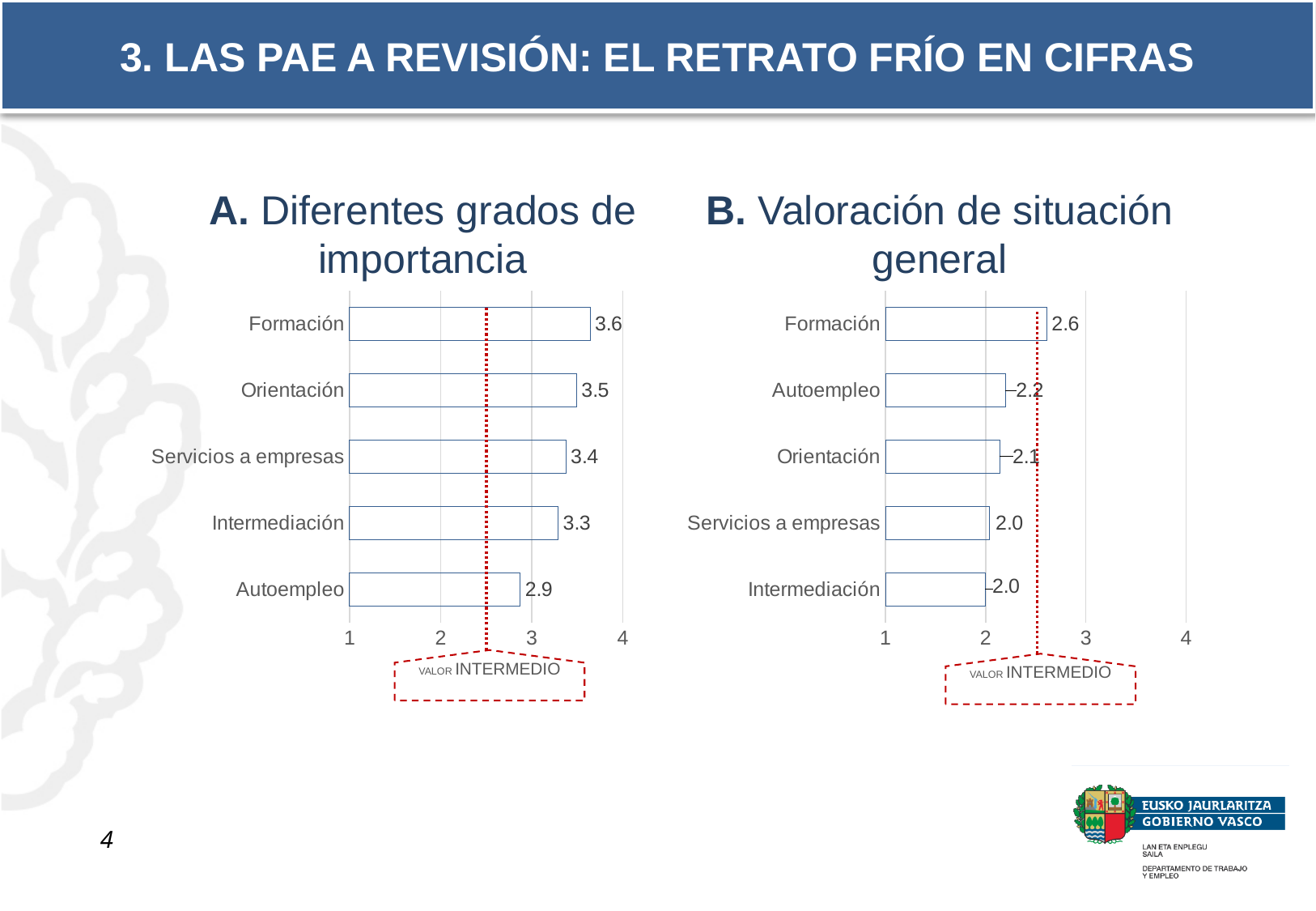
In chart A (Diferentes grados de importancia), what is the difference between Formación and Autoempleo? 0.7 In chart B (Valoración de situación general), what is the value for Formación? 2.6 In chart A (Diferentes grados de importancia), which category has the lowest value? Autoempleo In chart B (Valoración de situación general), what is the difference between Formación and Orientación? 0.5 Which is larger: Orientación in chart A or Orientación in chart B? Orientación in chart A In chart A (Diferentes grados de importancia), what is the value for Autoempleo? 2.9 What type of chart is chart A (Diferentes grados de importancia)? Bar chart In chart B (Valoración de situación general), is the value for Autoempleo greater or less than 3? less In chart B (Valoración de situación general), which category has the highest value? Formación In chart A (Diferentes grados de importancia), how many categories are shown? 5 In chart B (Valoración de situación general), what is the value for Autoempleo? 2.2 In chart A (Diferentes grados de importancia), what is the value for Formación? 3.6